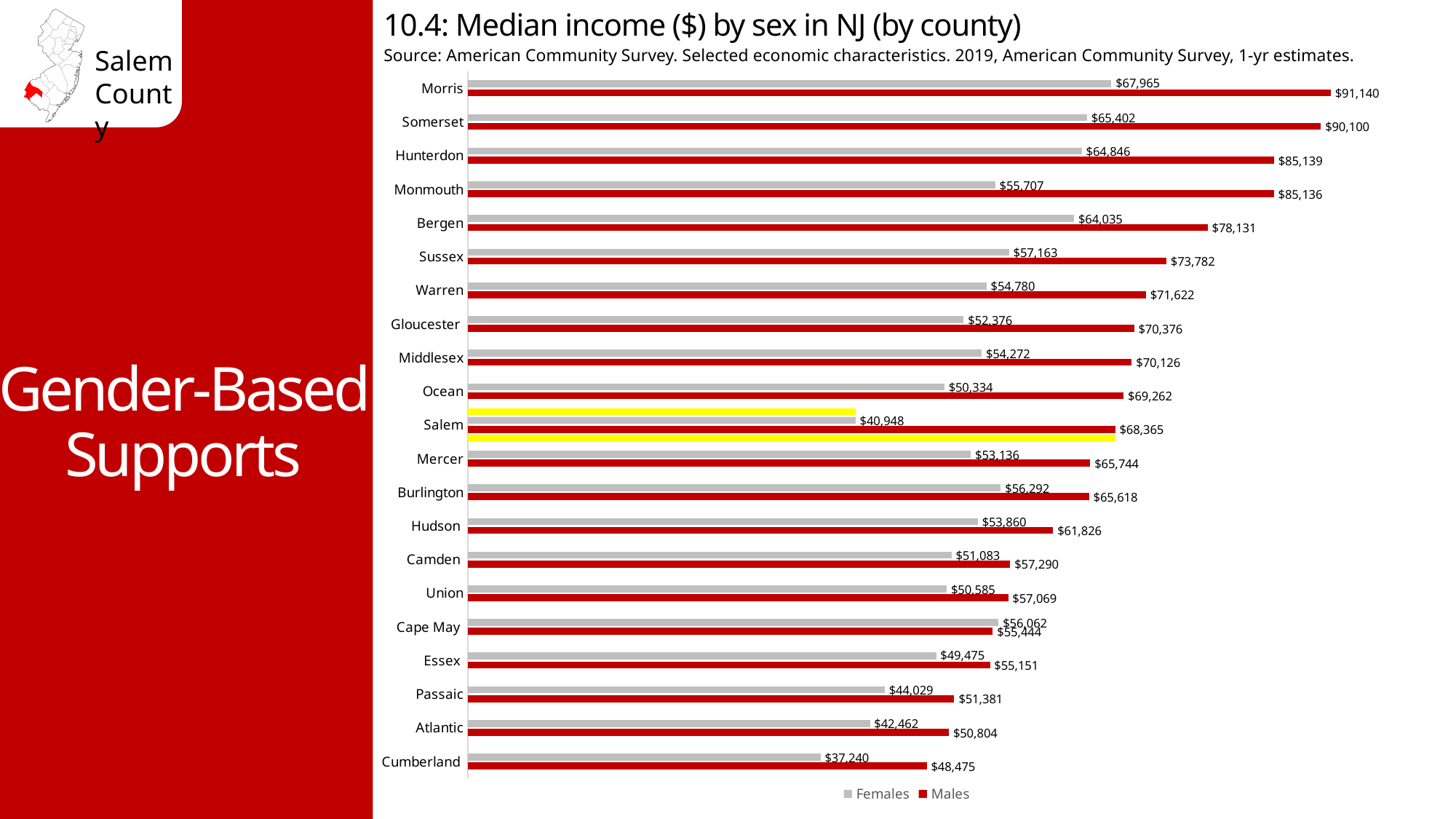
What is the median income for males in Monmouth County? $85,136 Which county has the lowest median income for females? Cumberland How many series does the legend list? 2 Which is larger: the female median income in Bergen County or in Monmouth County? Bergen In Cape May County, which is larger: the median income for females or for males? Females What is the difference between male and female median income in Salem County? $27,417 What kind of chart is shown on the slide? Bar chart What is the median income for females in Salem County? $40,948 How many counties are shown in the chart? 21 What is the difference between male and female median income in Morris County? $23,175 Which county has the highest median income for males? Morris What is the median income for males in Salem County? $68,365